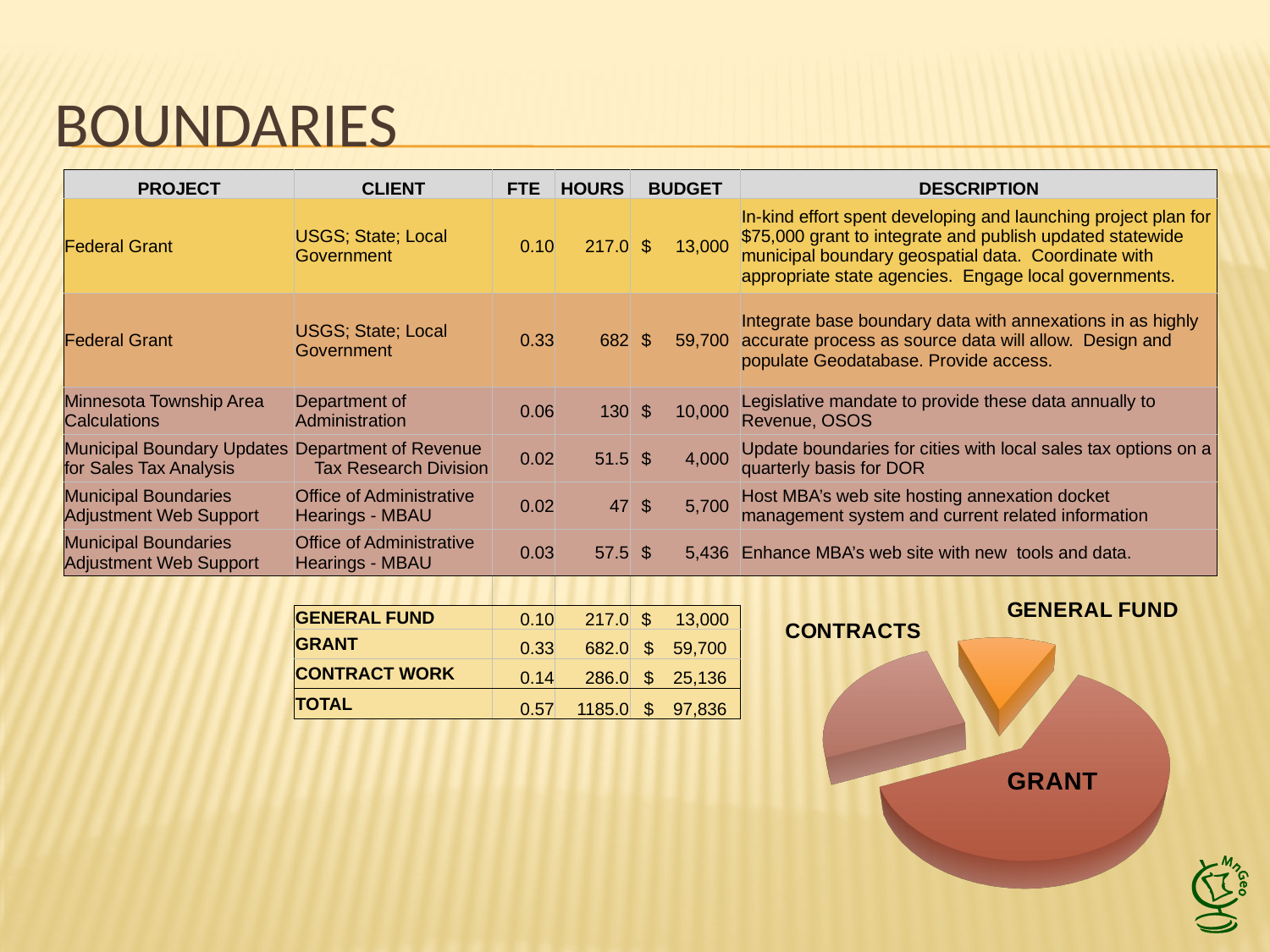
What kind of chart is shown on the slide? pie chart What colour is the GENERAL FUND slice in the pie chart? orange Which slice of the pie chart is the largest? GRANT In the pie chart, which slice is larger, GRANT or CONTRACTS? GRANT What are the three slice labels shown on the pie chart? GENERAL FUND, CONTRACTS, GRANT In the pie chart, which slice is larger, CONTRACTS or GENERAL FUND? CONTRACTS Which slice of the pie chart is the smallest? GENERAL FUND How many slices does the pie chart have? 3